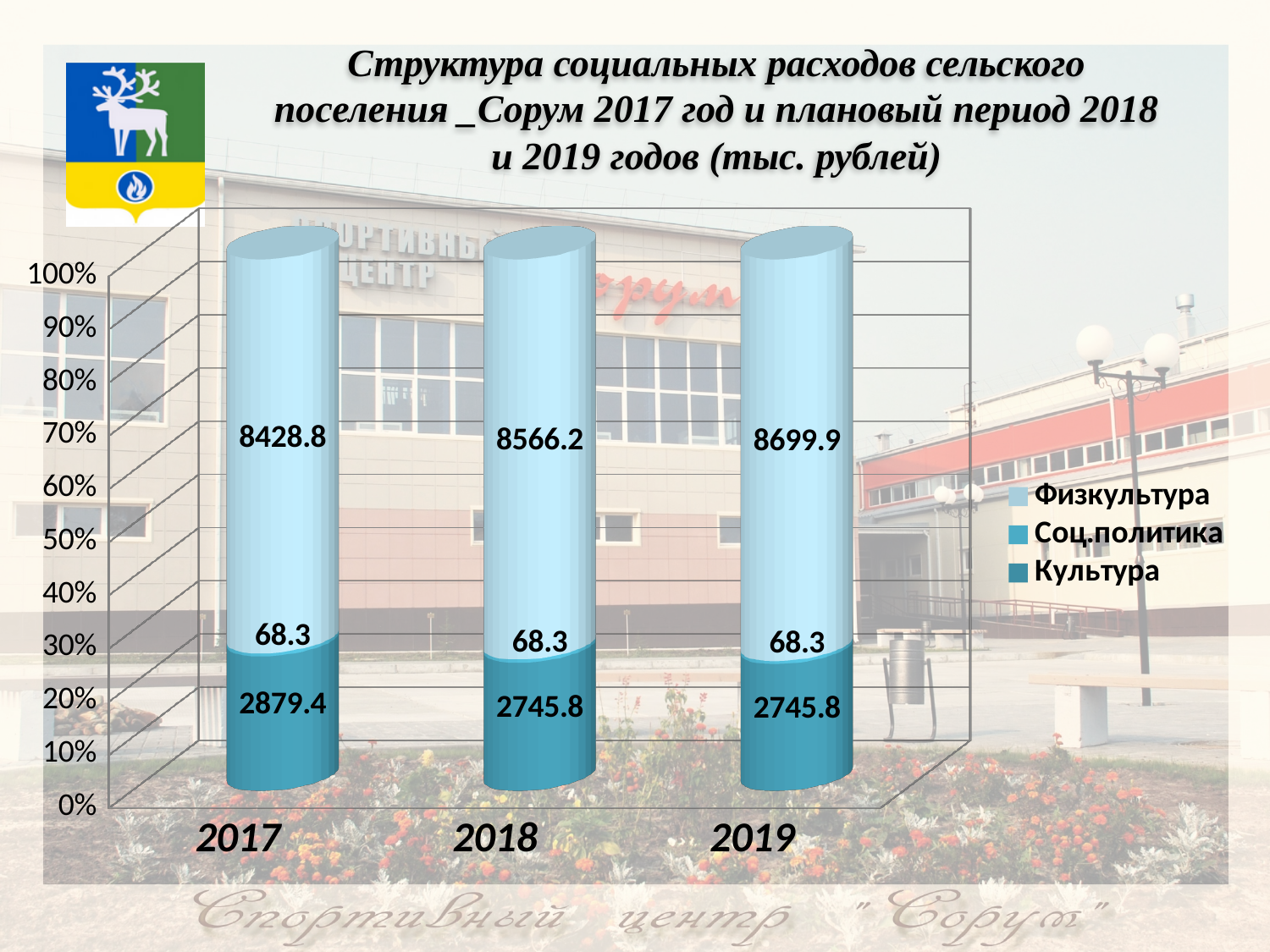
In which year is the value for Культура the highest? 2017 What is the total of the three values in the 2017 bar? 11376.5 Which is larger: the Культура value for 2017 or for 2018? 2017 How many years are shown on the x axis? 3 What kind of chart is shown on the slide? Stacked bar chart What is the difference between the Физкультура values for 2019 and 2017? 271.1 What is the value for Культура in 2018? 2745.8 In which year is the value for Физкультура the highest? 2019 What is the value for Физкультура in 2017? 8428.8 What is the value for Соц.политика in 2019? 68.3 How many series does the legend list? 3 What is the value for Физкультура in 2019? 8699.9